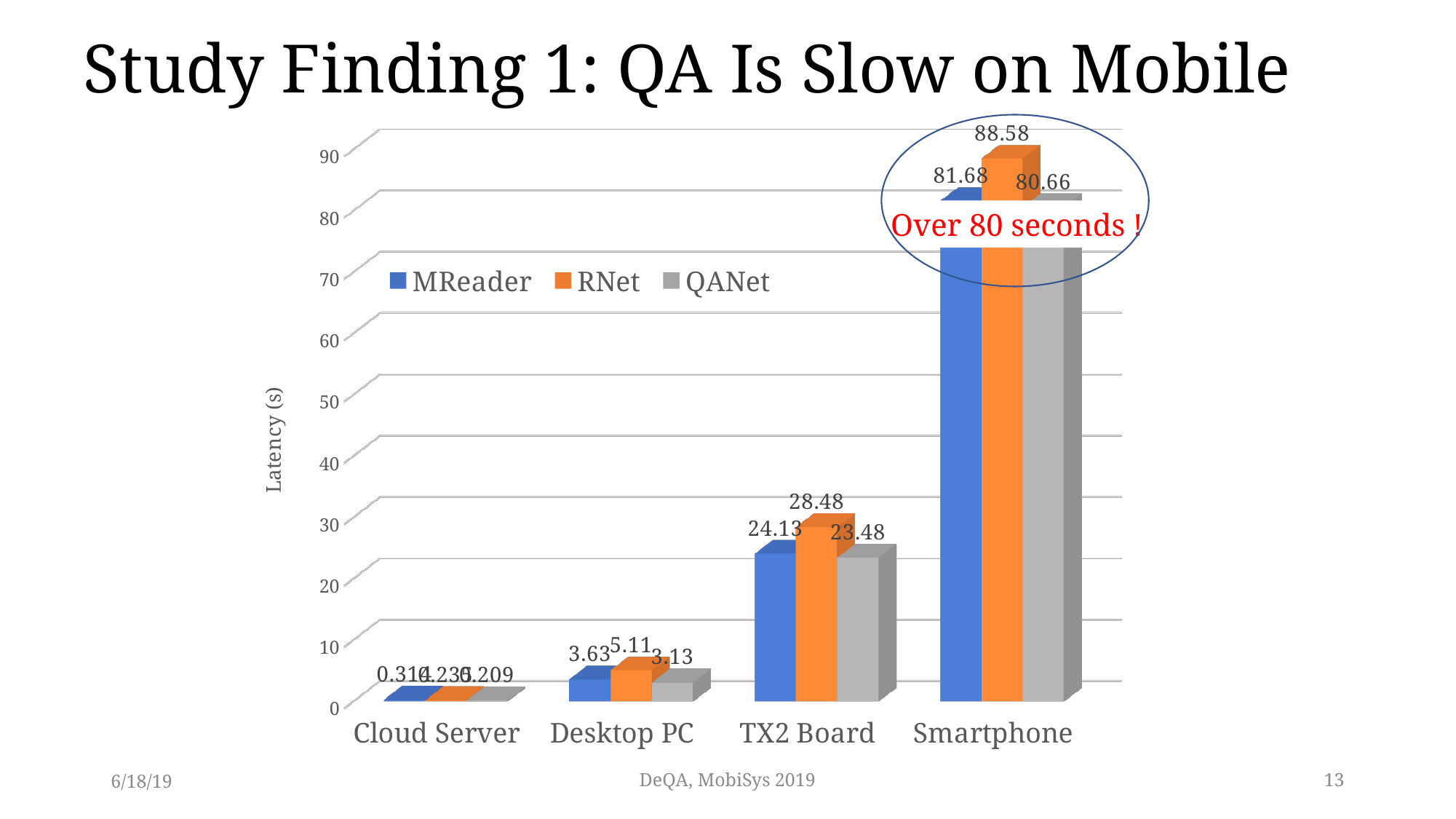
What is the RNet latency for Smartphone? 88.58 What is the difference between the RNet and QANet latencies for TX2 Board? 5 Which is larger for Smartphone, the MReader latency or the QANet latency? MReader Which device has the lowest MReader latency? Cloud Server What kind of chart is shown on the slide? bar chart What is the QANet latency for Smartphone? 80.66 Which device has the highest RNet latency? Smartphone How many devices are shown on the x axis? 4 What is the label of the y axis? Latency (s) What is the MReader latency for TX2 Board? 24.13 What is the QANet latency for Desktop PC? 3.13 How many series does the legend list? 3